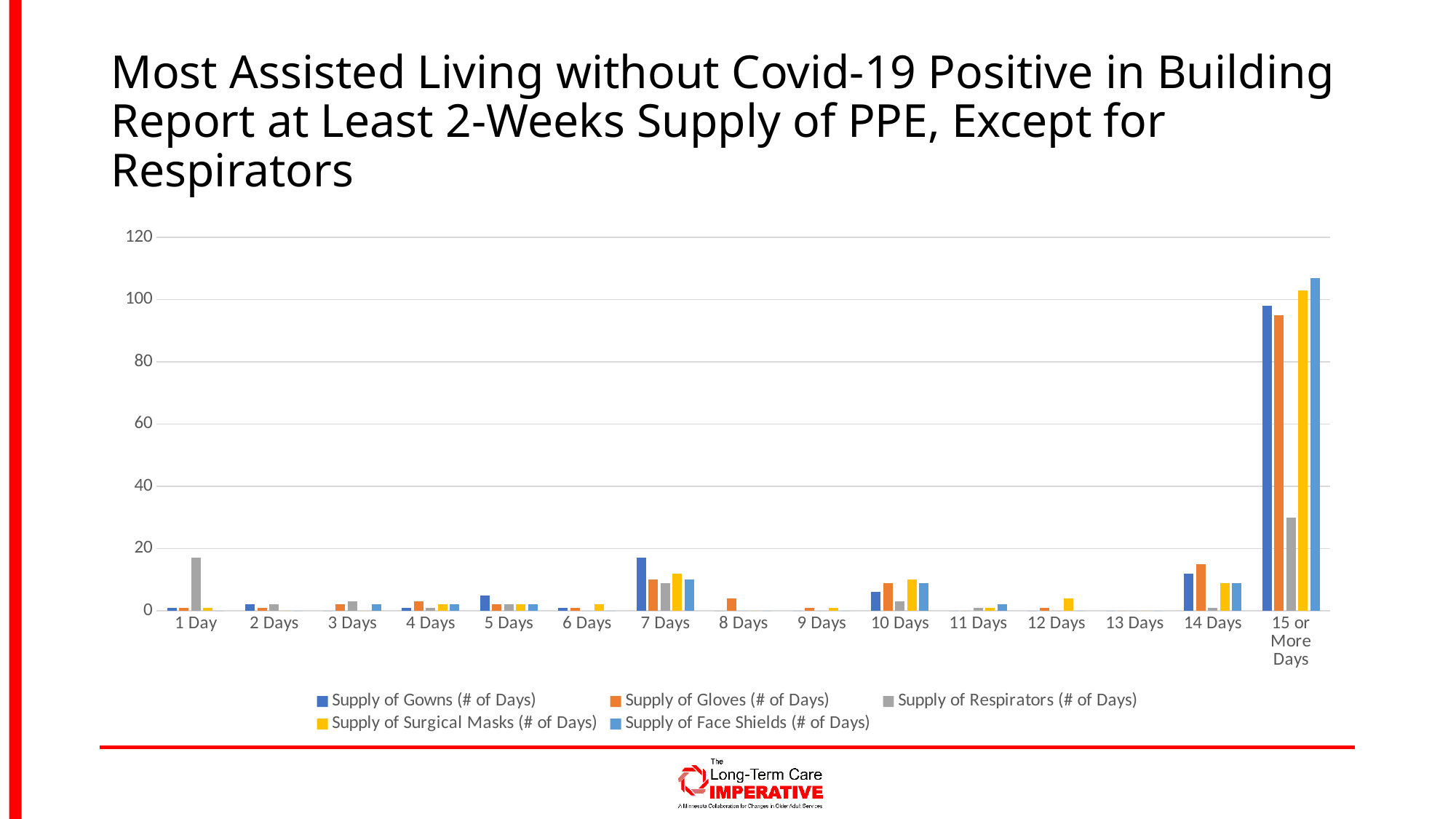
Which category has the highest value for Supply of Face Shields (# of Days)? 15 or More Days How many series does the legend list? 5 Is the value for Supply of Respirators (# of Days) at 15 or More Days greater or less than 40? less What kind of chart is shown on the slide? bar chart Is the value for Supply of Gowns (# of Days) at 7 Days greater or less than 20? less Is the value for Supply of Gloves (# of Days) at 15 or More Days greater or less than 100? less In the 15 or More Days category, which is larger: Supply of Face Shields (# of Days) or Supply of Respirators (# of Days)? Supply of Face Shields (# of Days) Which series has the lowest value in the 15 or More Days category? Supply of Respirators (# of Days) Which series has the highest value in the 1 Day category? Supply of Respirators (# of Days) How many categories are shown along the x axis? 15 What colour are the bars for Supply of Surgical Masks (# of Days)? yellow